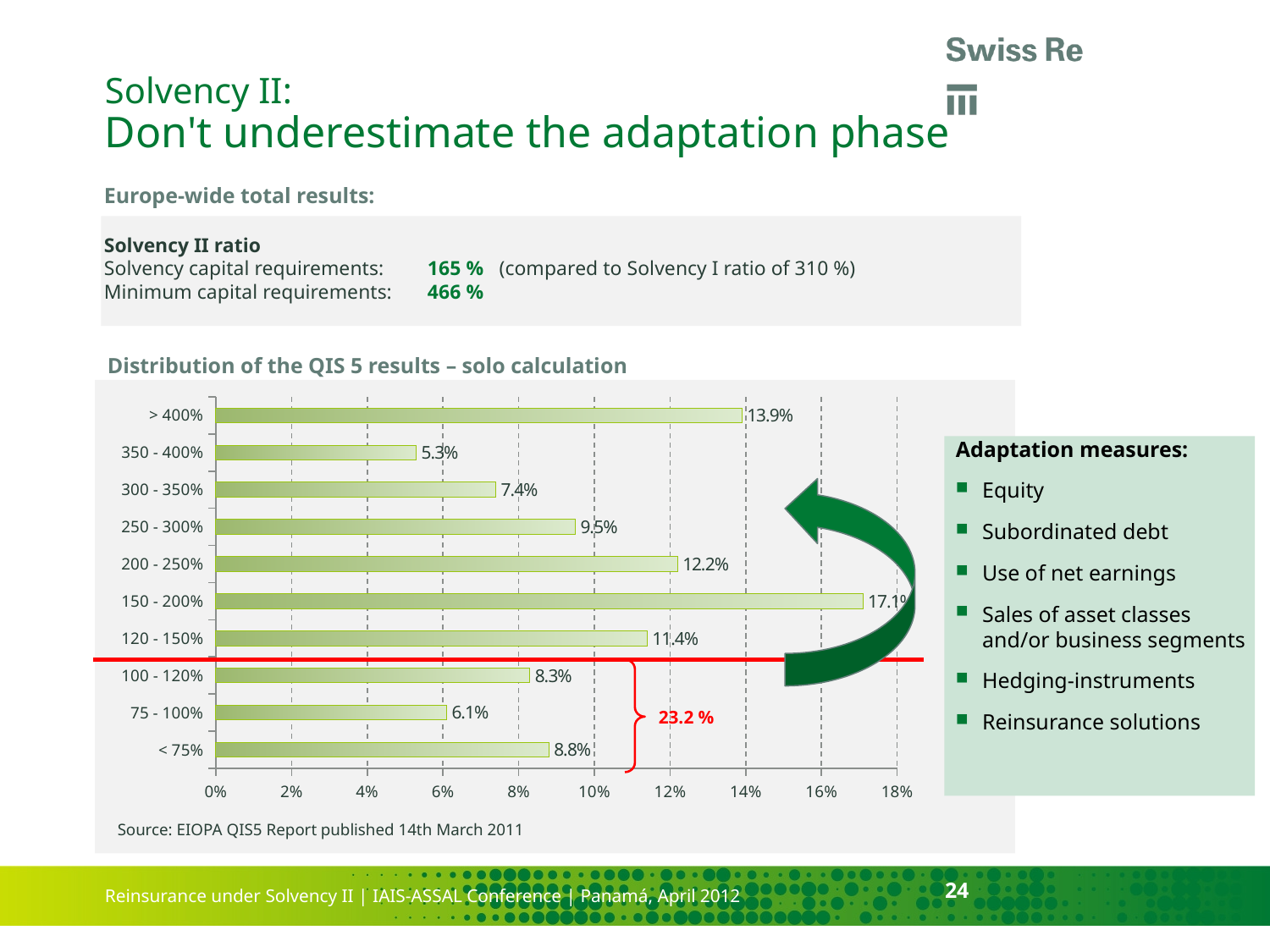
What is the combined share of the three categories below the red line (100 - 120%, 75 - 100%, < 75%)? 23.2 % What is the value for the '> 400%' category? 13.9% What is the difference between the values for '200 - 250%' and '250 - 300%'? 2.7% How many categories are shown on the chart? 10 Is the value for '300 - 350%' greater or less than 8%? less What is the value for the '75 - 100%' category? 6.1% Which category has the lowest value? 350 - 400% Which is larger, the value for '120 - 150%' or the value for '< 75%'? 120 - 150% What is the value for the '150 - 200%' category? 17.1% Which category has the highest value? 150 - 200% What is the title of the chart? Distribution of the QIS 5 results – solo calculation What kind of chart is shown under 'Distribution of the QIS 5 results – solo calculation'? Bar chart